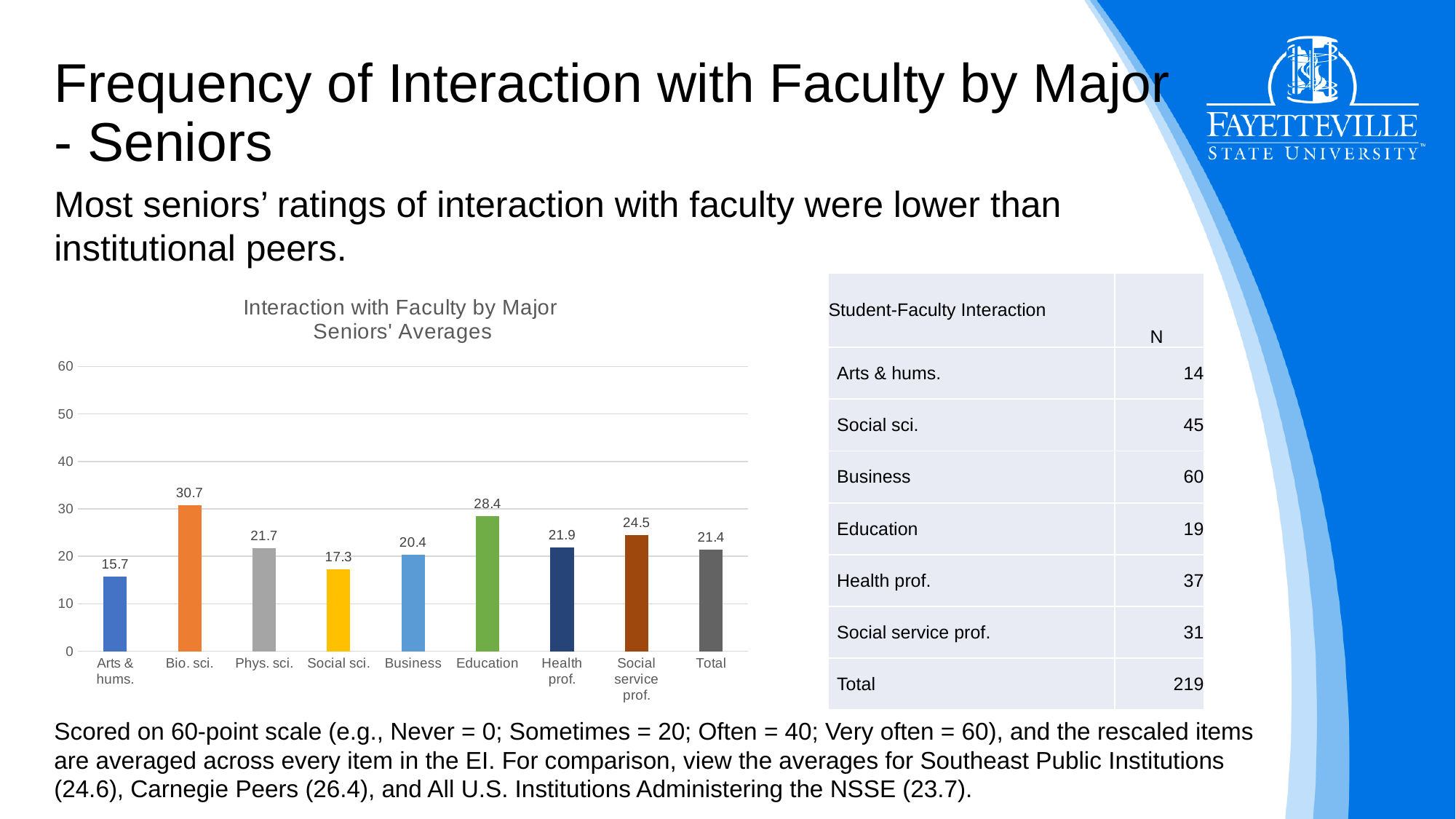
What is the value of the Total bar in the chart? 21.4 What kind of chart is shown on the slide? bar chart What is the value shown for Social service prof. in the chart? 24.5 Which major has the highest seniors' average in the chart? Bio. sci. What is the difference between the Bio. sci. value and the Social sci. value in the chart? 13.4 How many bars are plotted in the Interaction with Faculty by Major chart? 9 Which is larger in the chart, the value for Education or the value for Business? Education What is the title of the chart on the slide? Interaction with Faculty by Major Seniors' Averages Which major has the lowest seniors' average in the chart? Arts & hums. What is the seniors' average for Arts & hums. in the chart? 15.7 Is the value for Phys. sci. in the chart greater or less than 30? less What is the seniors' average for Bio. sci. in the Interaction with Faculty by Major chart? 30.7